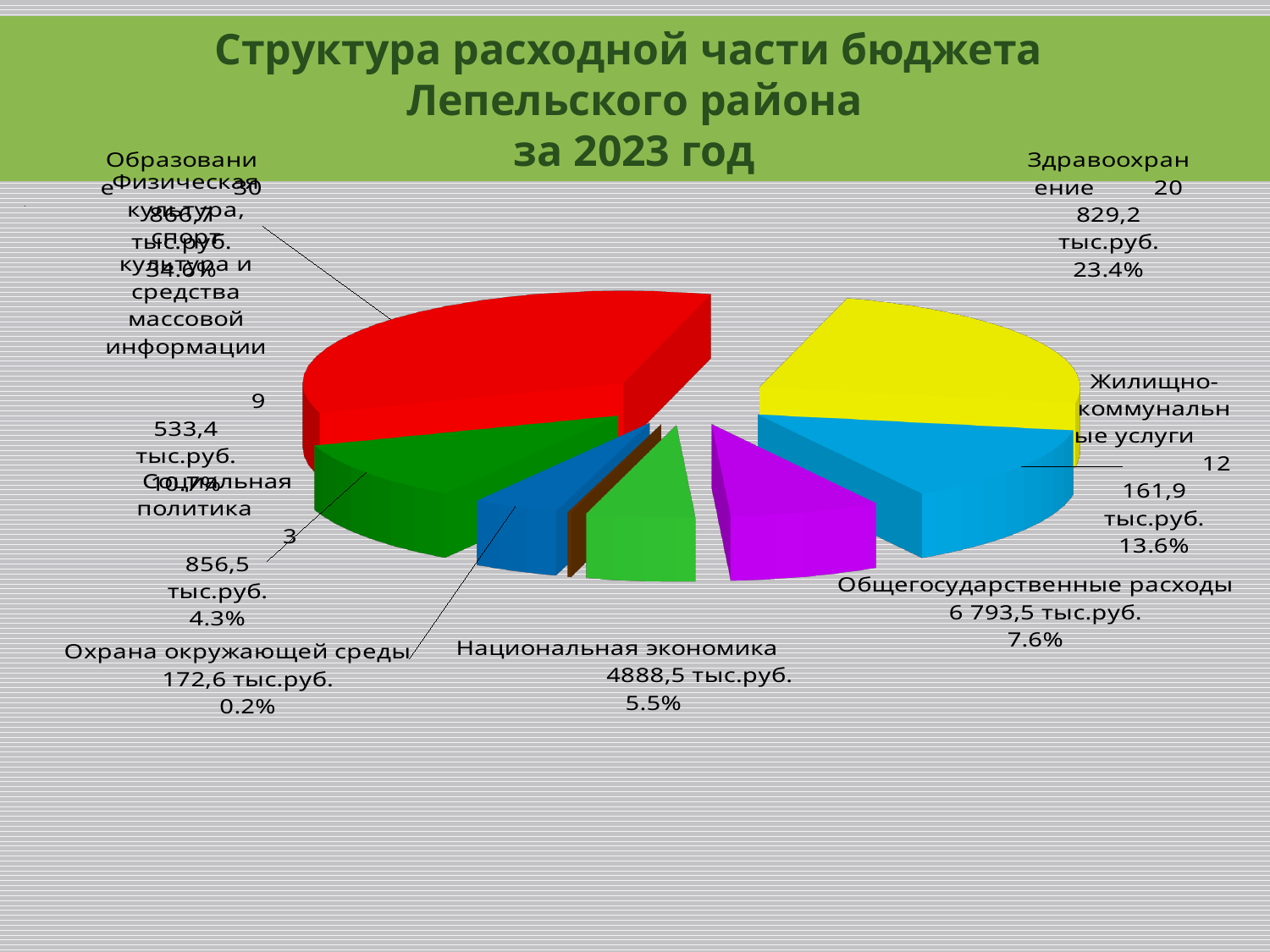
What is the amount in тыс.руб. for Здравоохранение? 20 829,2 тыс.руб. By how many percentage points does the share of Здравоохранение exceed that of Жилищно-коммунальные услуги? 9.8% What kind of chart is shown on the slide? pie chart What share of the budget expenditure goes to Жилищно-коммунальные услуги? 13.6% What is the amount in тыс.руб. for Общегосударственные расходы? 6 793,5 тыс.руб. What share of the budget expenditure goes to Национальная экономика? 5.5% Which has a larger share: Здравоохранение or Жилищно-коммунальные услуги? Здравоохранение What share of the budget expenditure goes to Социальная политика? 4.3% What share of the budget expenditure goes to Здравоохранение? 23.4% What is the amount in тыс.руб. for Охрана окружающей среды? 172,6 тыс.руб. Which category has the largest share of the budget expenditure? Образование Which category has the smallest share of the budget expenditure? Охрана окружающей среды